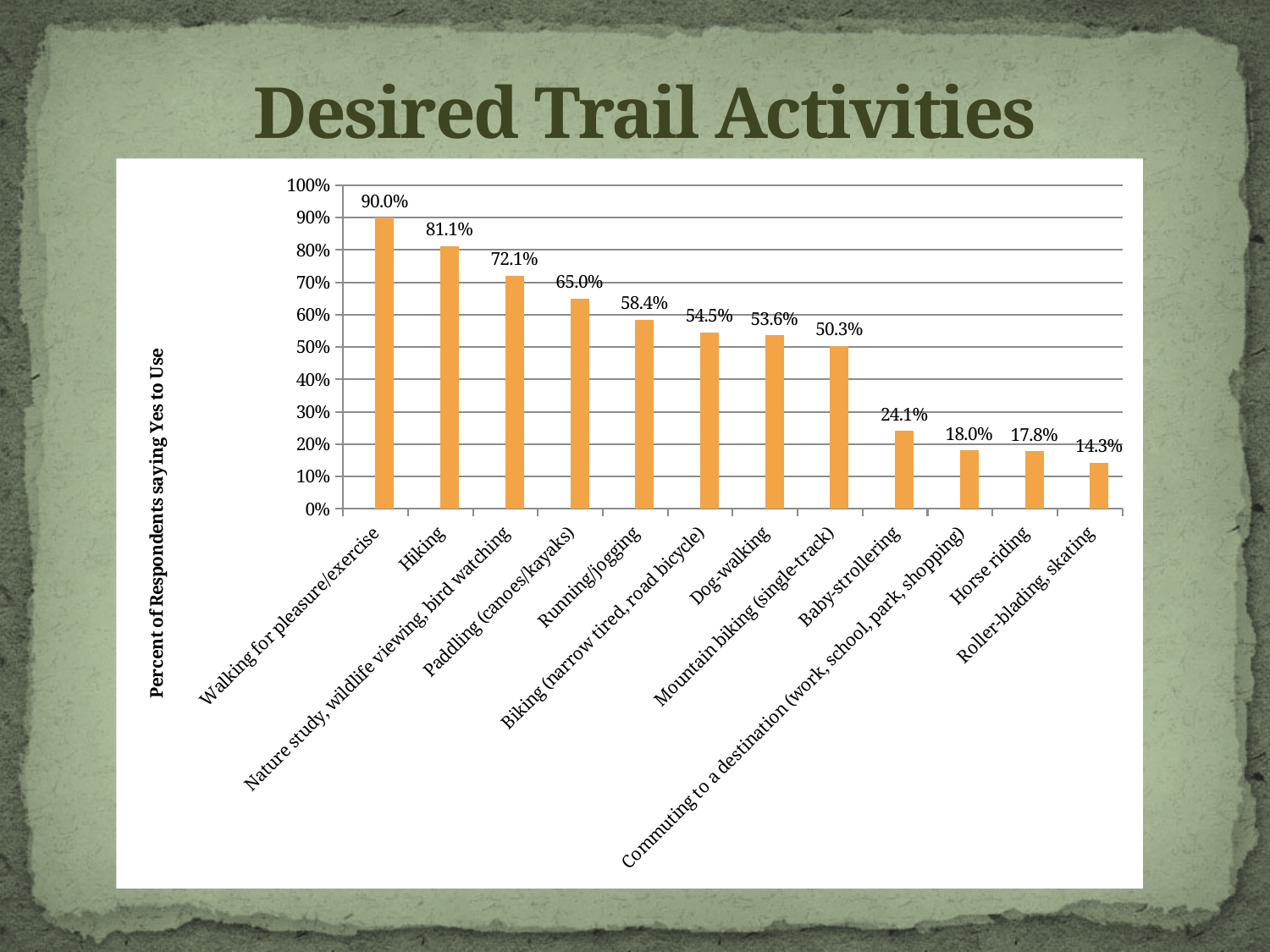
Which activity has the highest percentage of respondents saying yes? Walking for pleasure/exercise What kind of chart is shown on the slide? Bar chart Is the value for Baby-strollering greater or less than 30%? less What percentage of respondents said yes to walking for pleasure/exercise? 90.0% What percentage of respondents said yes to Dog-walking? 53.6% What is the value for Hiking? 81.1% Which has a higher value, Paddling (canoes/kayaks) or Mountain biking (single-track)? Paddling (canoes/kayaks) What is the value for Horse riding? 17.8% Which activity has the lowest percentage of respondents saying yes? Roller-blading, skating How many activities are shown on the chart? 12 What is the label on the vertical axis of the chart? Percent of Respondents saying Yes to Use What is the difference between the values for Hiking and Running/jogging? 22.7%